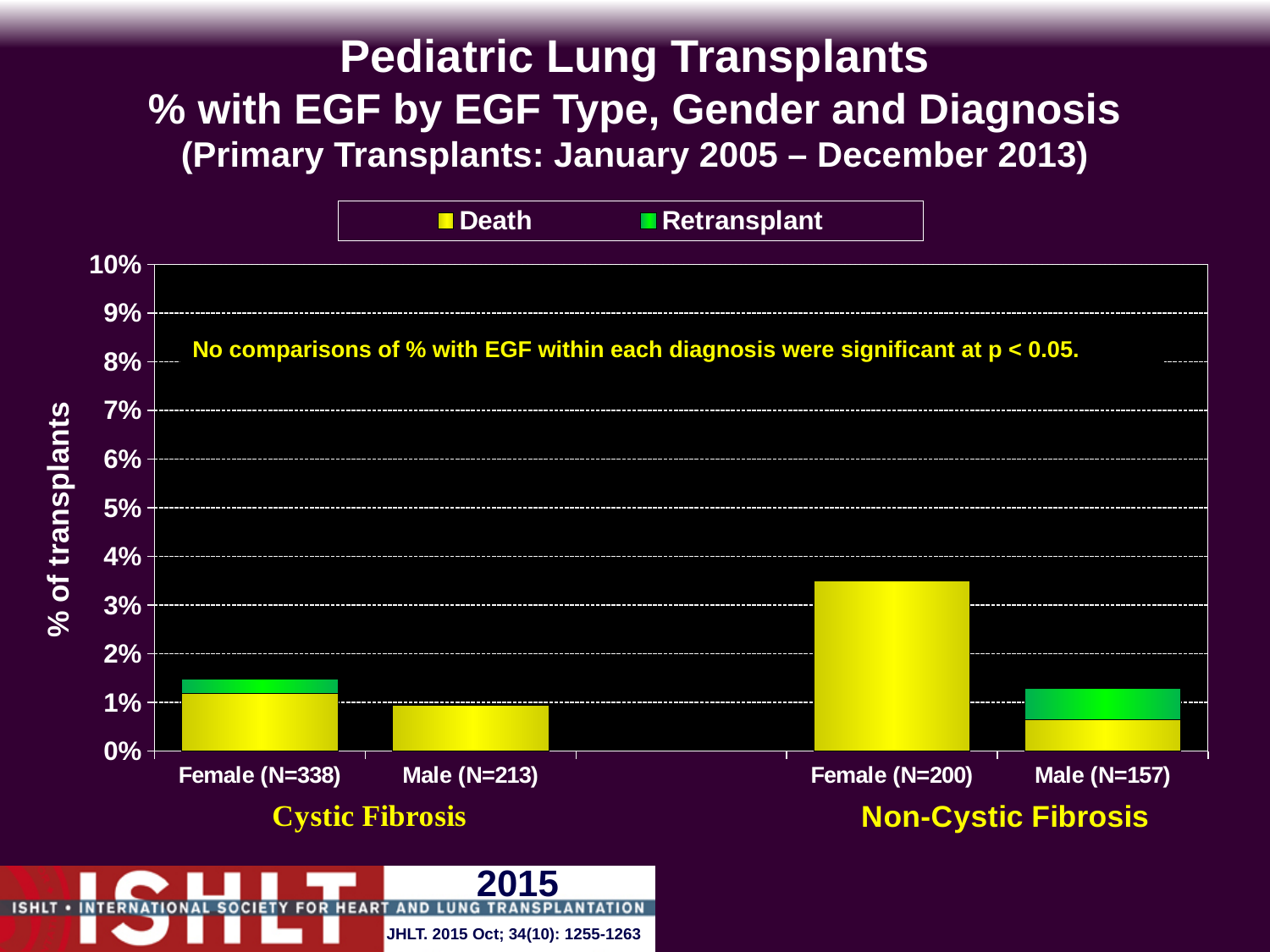
Which has a larger total % with EGF: Female (N=200) or Male (N=157)? Female (N=200) Which has a larger total % with EGF: Female (N=338) or Male (N=213)? Female (N=338) What is the label of the y axis? % of transplants Which category has the highest total % of transplants with EGF? Female (N=200) How many series does the legend list? 2 How many gender/diagnosis categories are plotted along the x axis? 4 What kind of chart is shown on the slide? bar chart Which category has the lowest total % of transplants with EGF? Male (N=213) Is the total value for Female (N=200) greater or less than 3%? greater Is the total value for Female (N=338) greater or less than 2%? less Which colour represents the Retransplant series in the legend? green